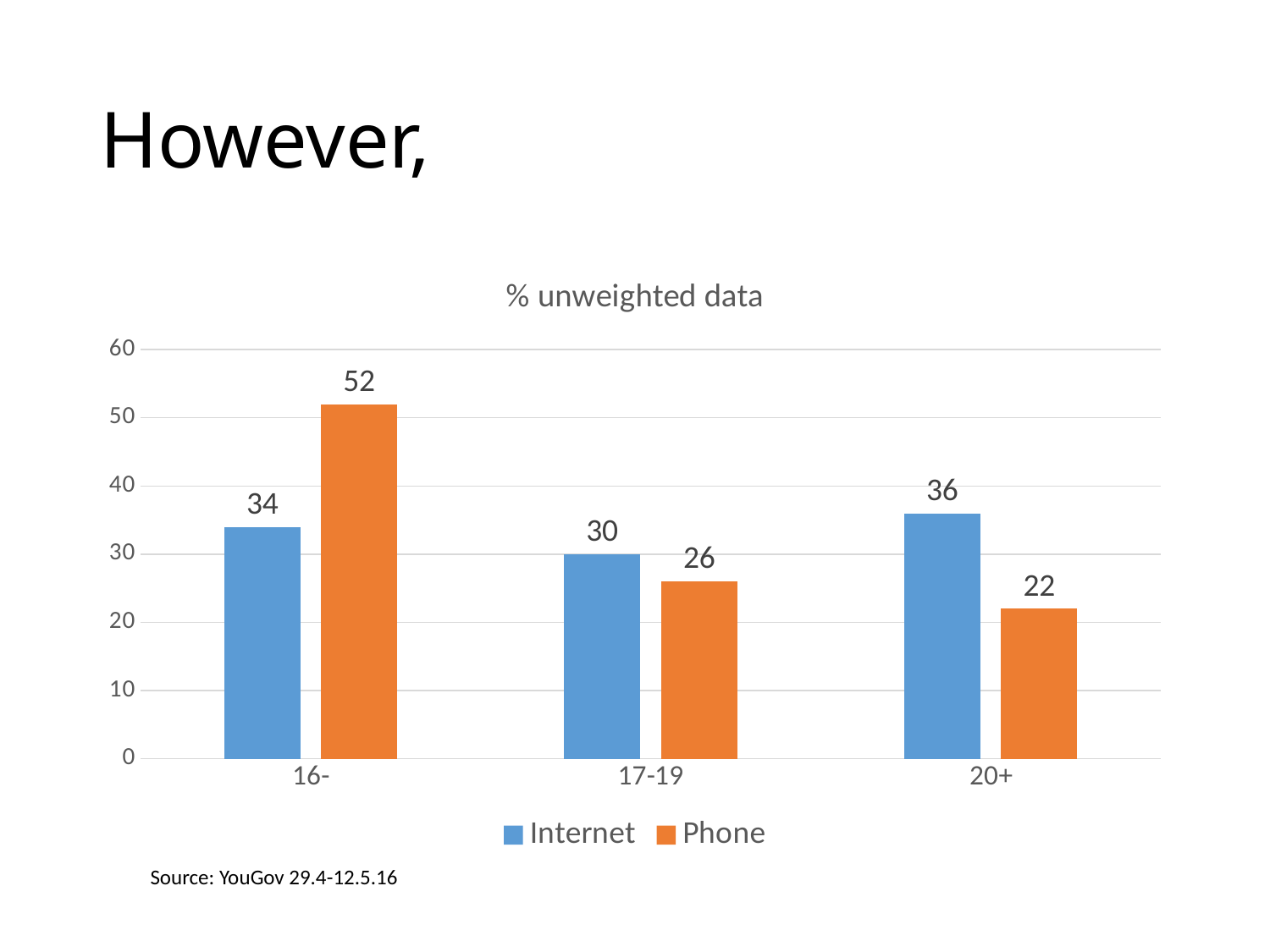
What is the title of the chart? % unweighted data Which category has the lowest Internet value? 17-19 What kind of chart is shown on the slide? Bar chart What is the Internet value for the 16- category? 34 For the 20+ category, which is larger, Internet or Phone? Internet How many series does the legend list? 2 Which category has the highest Phone value? 16- What is the Internet value for the 17-19 category? 30 What is the Phone value for the 20+ category? 22 What is the Phone value for the 16- category? 52 What is the difference between the Phone and Internet values for the 16- category? 18 How many age categories are shown on the x axis? 3